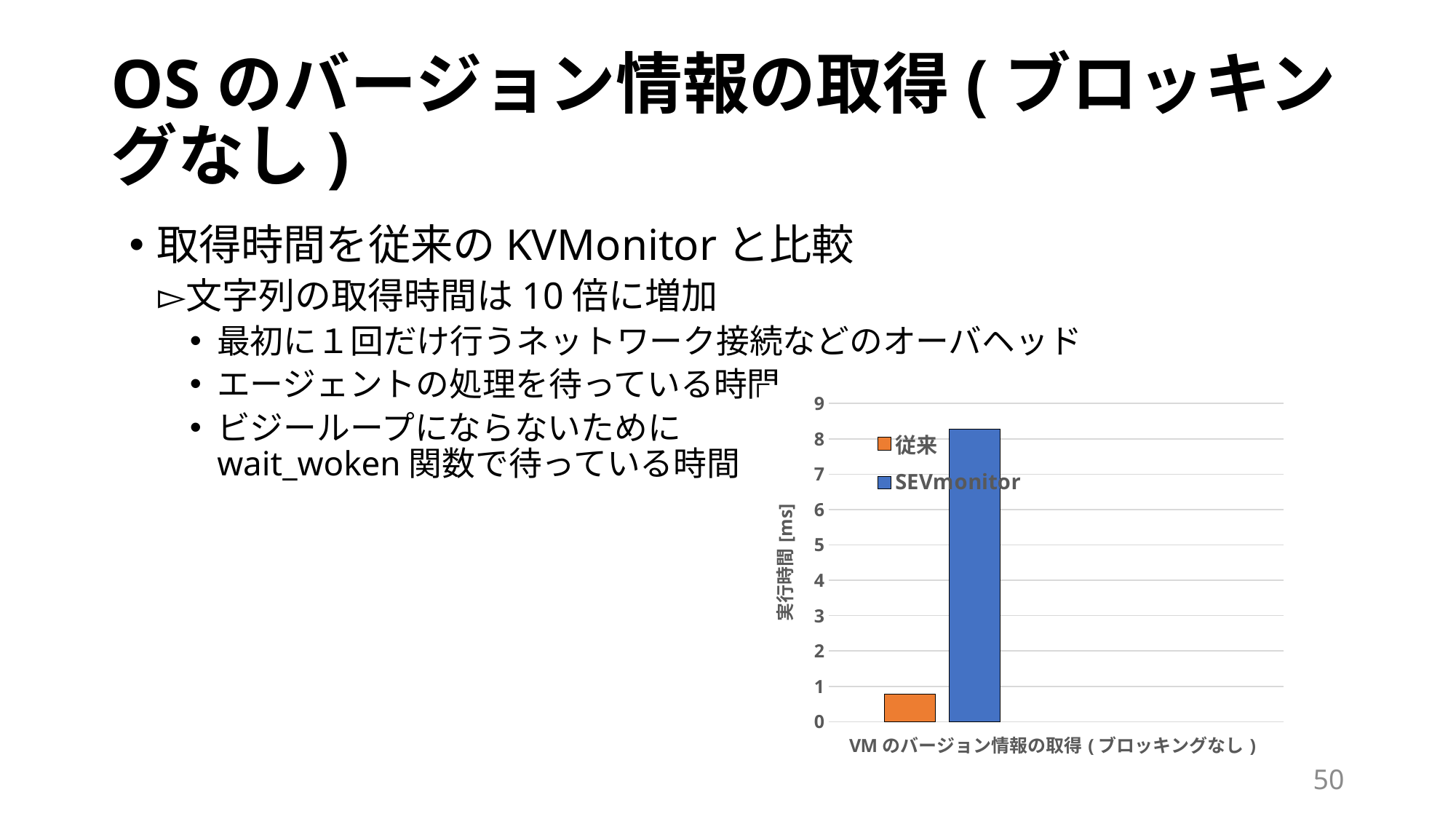
How many categories are shown on the x axis of the chart? 1 Is the value for 従来 greater or less than 1? less What colour is the bar for the SEVmonitor series? blue Is the value for SEVmonitor greater or less than 5? greater How many series does the chart legend list? 2 What is the label of the y axis of the chart? 実行時間 [ms] Which series has the taller bar, 従来 or SEVmonitor? SEVmonitor Is the value for SEVmonitor greater or less than 8? greater Which series has the lowest value in the chart? 従来 What kind of chart is shown on the slide? bar chart Which series has the highest value in the chart? SEVmonitor